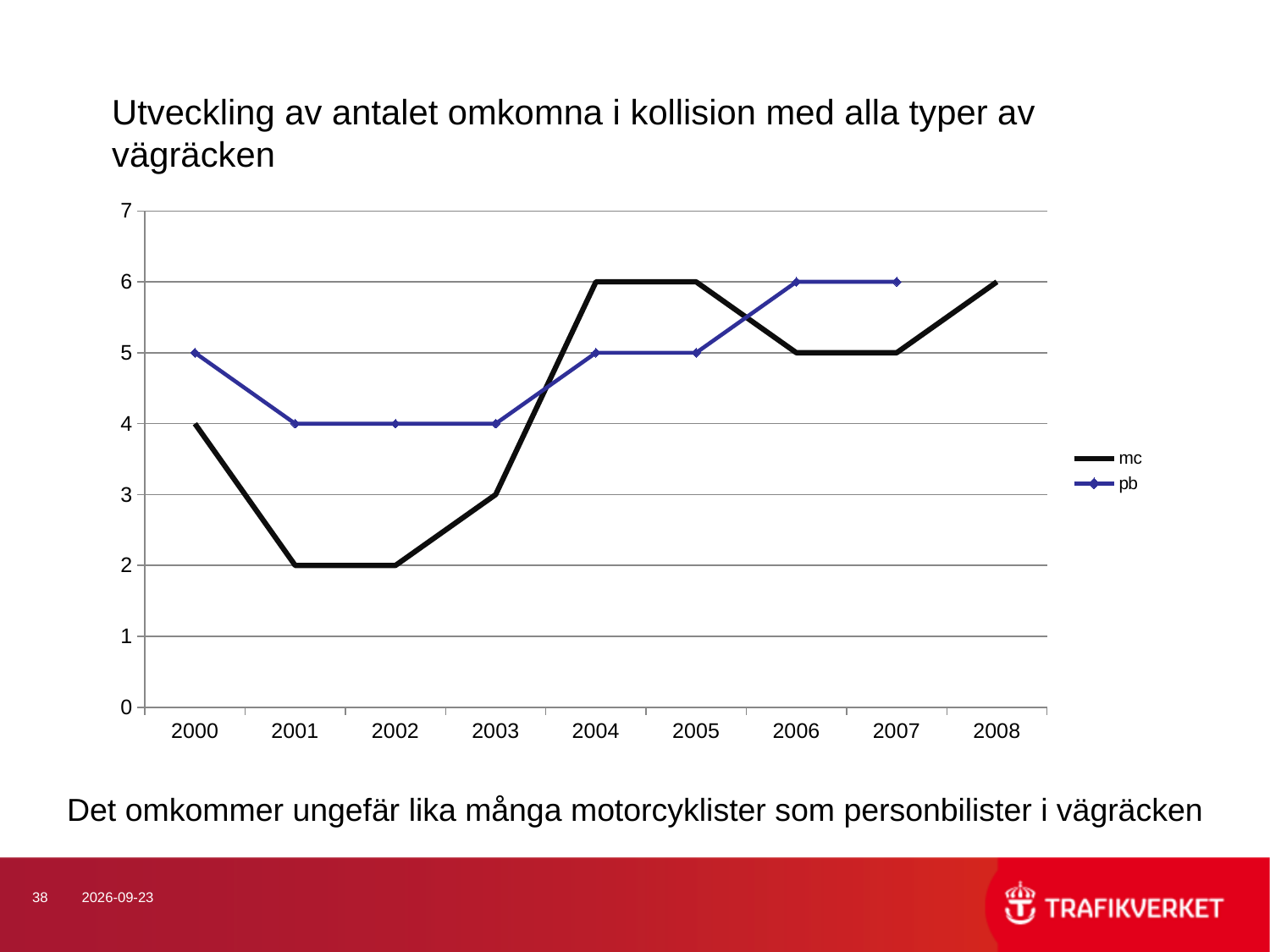
What is the value for mc in 2008? 6 What type of chart is shown on the slide? Line chart In which year is the mc series at its lowest value? 2001 and 2002 How many series does the legend list? 2 Which series has the higher value in 2004, mc or pb? mc What is the difference between the pb value and the mc value in 2001? 2 What is the value for pb in 2006? 6 Does the pb series rise or fall from 2003 to 2006? Rise What is the value for mc in 2001? 2 What is the value for pb in 2000? 5 How many years are shown on the x axis? 9 What is the title of the chart? Utveckling av antalet omkomna i kollision med alla typer av vägräcken